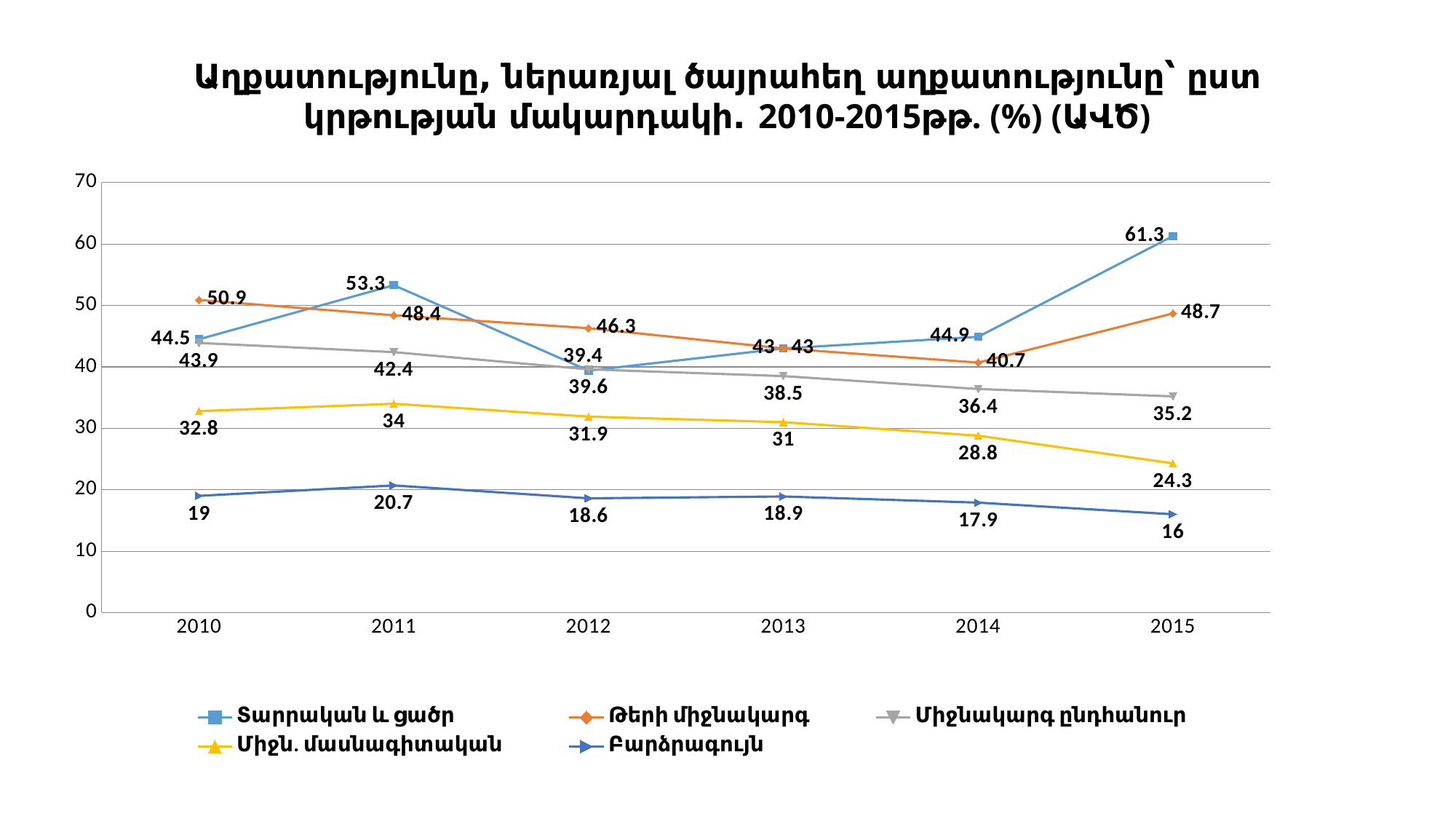
What is the value for Տարրական և ցածր in 2015? 61.3 How many years are shown on the x axis? 6 What type of chart is shown on the slide? line chart In which year is the value for Թերի միջնակարգ lowest? 2014 What is the value for Միջնակարգ ընդհանուր in 2013? 38.5 What is the difference between the Միջն. մասնագիտական values in 2010 and 2015? 8.5 Does the value for Միջնակարգ ընդհանուր rise or fall from 2010 to 2015? fall Which series is drawn in yellow? Միջն. մասնագիտական Which is larger in 2011: Տարրական և ցածր or Թերի միջնակարգ? Տարրական և ցածր How many series does the legend list? 5 In which year is the value for Տարրական և ցածր highest? 2015 What is the value for Բարձրագույն in 2011? 20.7